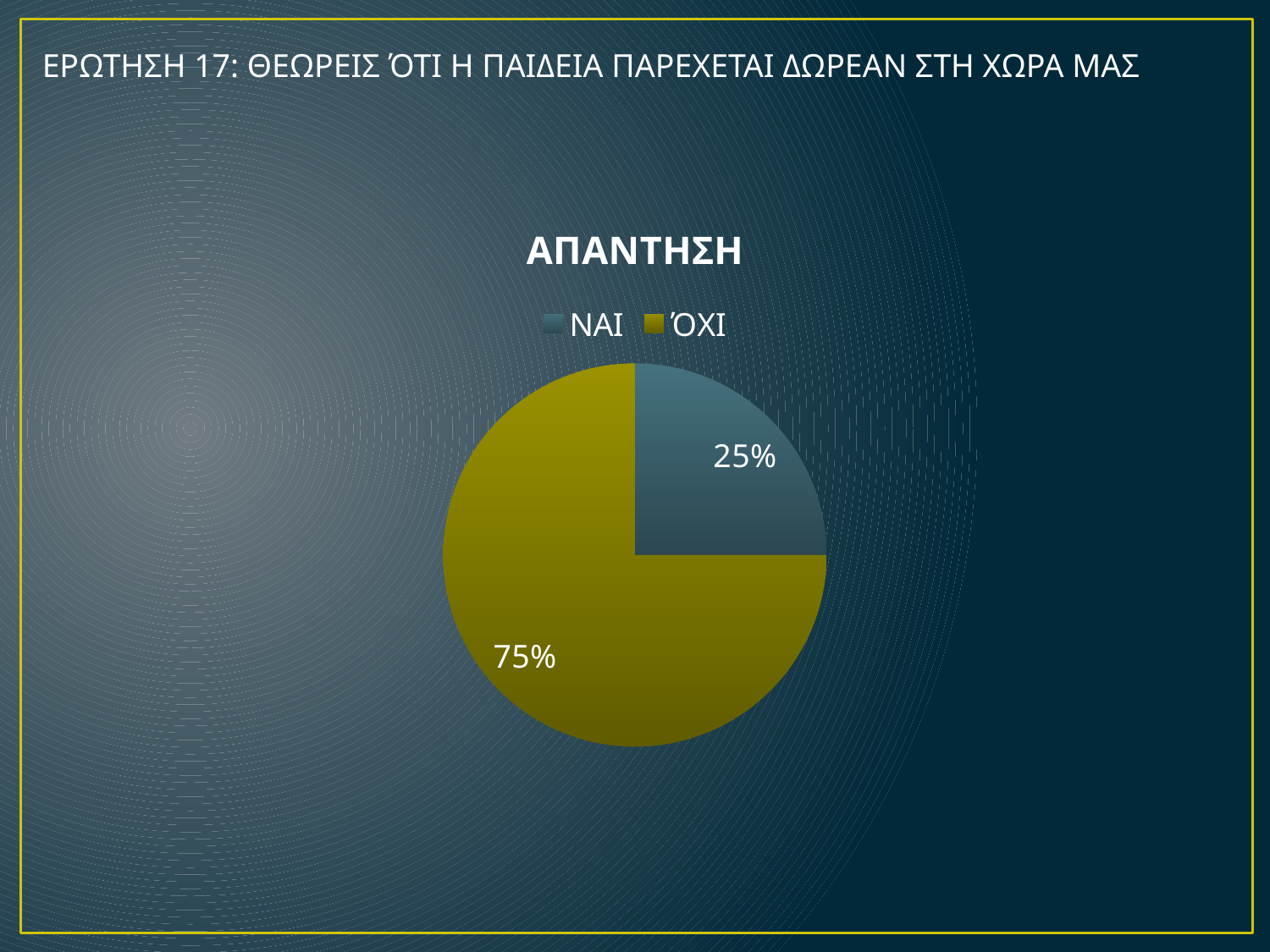
What is the difference in percentage points between the ΌΧΙ and ΝΑΙ slices? 50 How many entries does the legend list? 2 What percentage of the pie chart is labelled ΌΧΙ? 75% What percentage of the pie chart is labelled ΝΑΙ? 25% What type of chart is shown on the slide? Pie chart How many slices does the pie chart have? 2 What share of the pie does the ΌΧΙ slice represent? 75% What is the title of the chart? ΑΠΑΝΤΗΣΗ Which category has the largest share of the pie chart? ΌΧΙ Which slice is larger, ΝΑΙ or ΌΧΙ? ΌΧΙ Which colour represents ΌΧΙ in the pie chart? Yellow (olive) Which category has the smallest share of the pie chart? ΝΑΙ